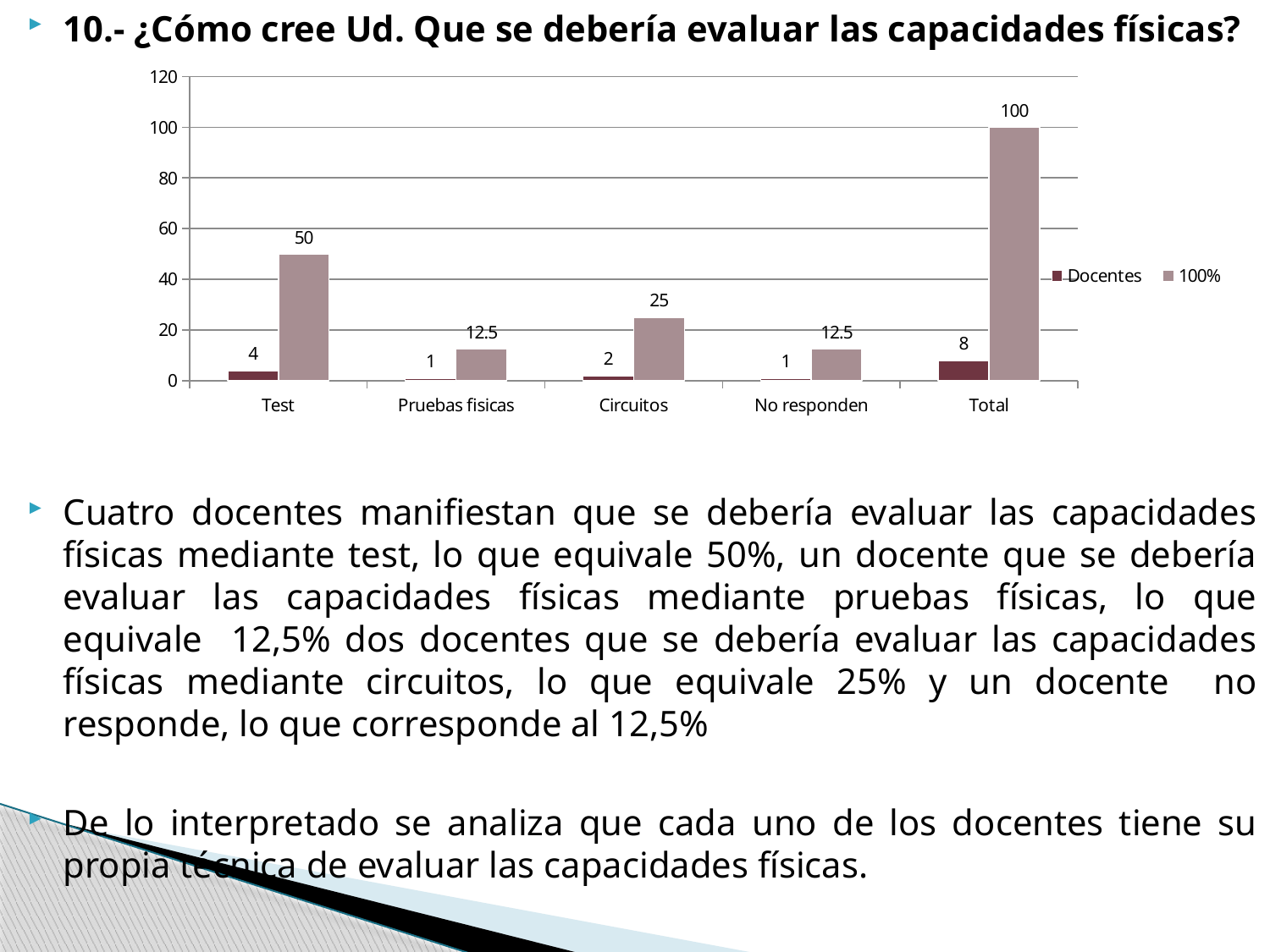
What is the 100% value for Circuitos? 25 What kind of chart is shown? bar chart What is the 100% value for Pruebas fisicas? 12.5 How many series does the legend list? 2 What is the Docentes value for Test? 4 Is the 100% value for Total greater or less than 80? greater What are the two series names in the legend? Docentes and 100% How many categories are shown on the x axis? 5 Which is larger, the Docentes value for Circuitos or for No responden? Circuitos What is the difference between the 100% values for Test and Circuitos? 25 Excluding Total, which category has the highest 100% value? Test What is the Docentes value for Total? 8